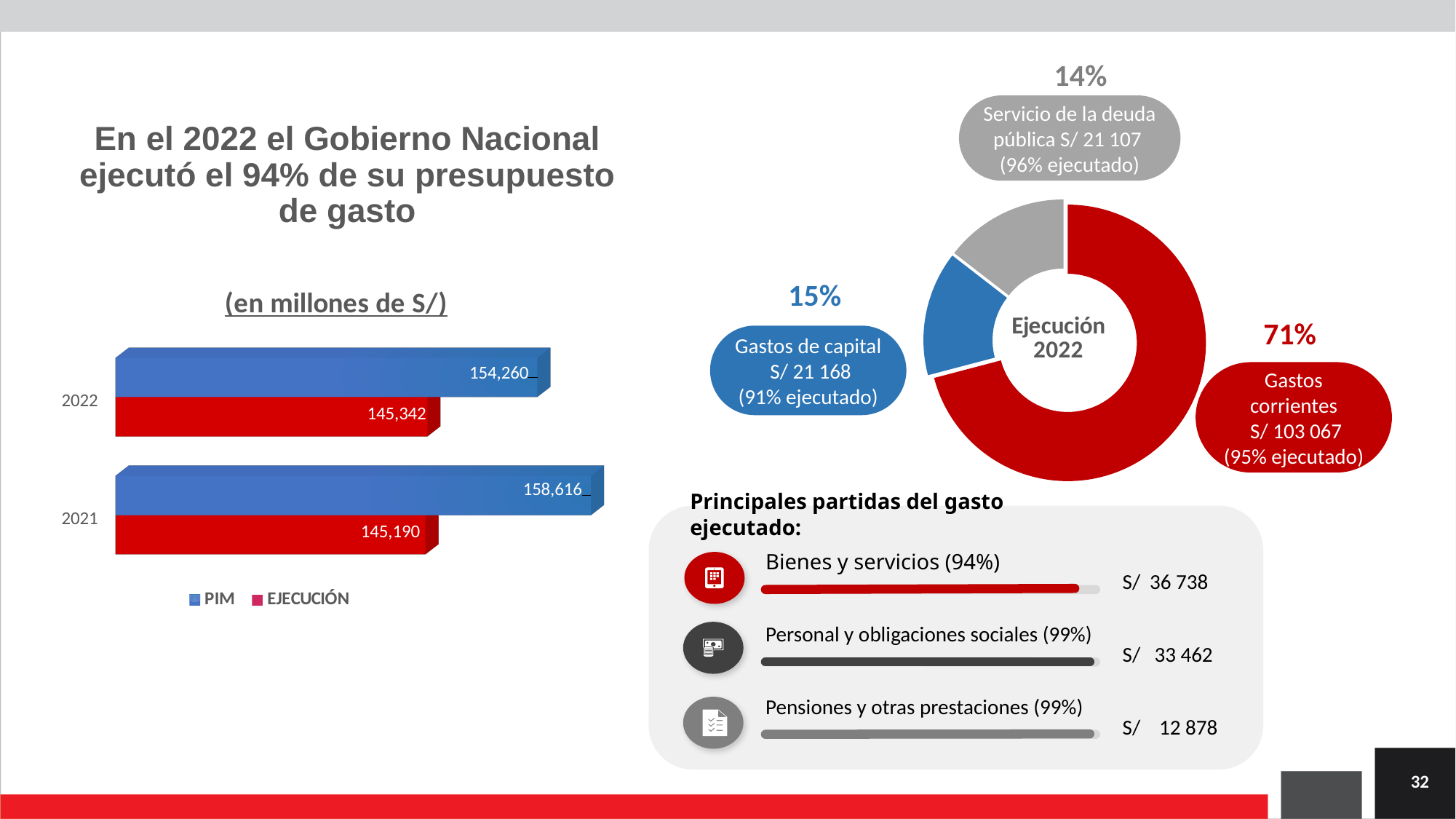
In the donut chart titled Ejecución 2022, which category has the smallest share? Servicio de la deuda pública In the donut chart titled Ejecución 2022, what colour is the Gastos corrientes slice? Red In the donut chart titled Ejecución 2022, how many slices are there? 3 In the bar chart on the left (en millones de S/), what is the EJECUCIÓN value for 2021? 145,190 In the bar chart on the left (en millones de S/), what is the difference between PIM and EJECUCIÓN for 2022? 8,918 What kind of chart is the chart on the left (en millones de S/)? Bar chart In the donut chart titled Ejecución 2022, what is the amount shown for Gastos de capital? S/ 21 168 In the bar chart on the left (en millones de S/), which year has the higher PIM value? 2021 In the donut chart titled Ejecución 2022, what share does Gastos corrientes represent? 71% In the bar chart on the left (en millones de S/), what is the PIM value for 2022? 154,260 In the bar chart on the left (en millones de S/), how many series does the legend list? 2 In the bar chart on the left (en millones de S/), how many years are shown? 2